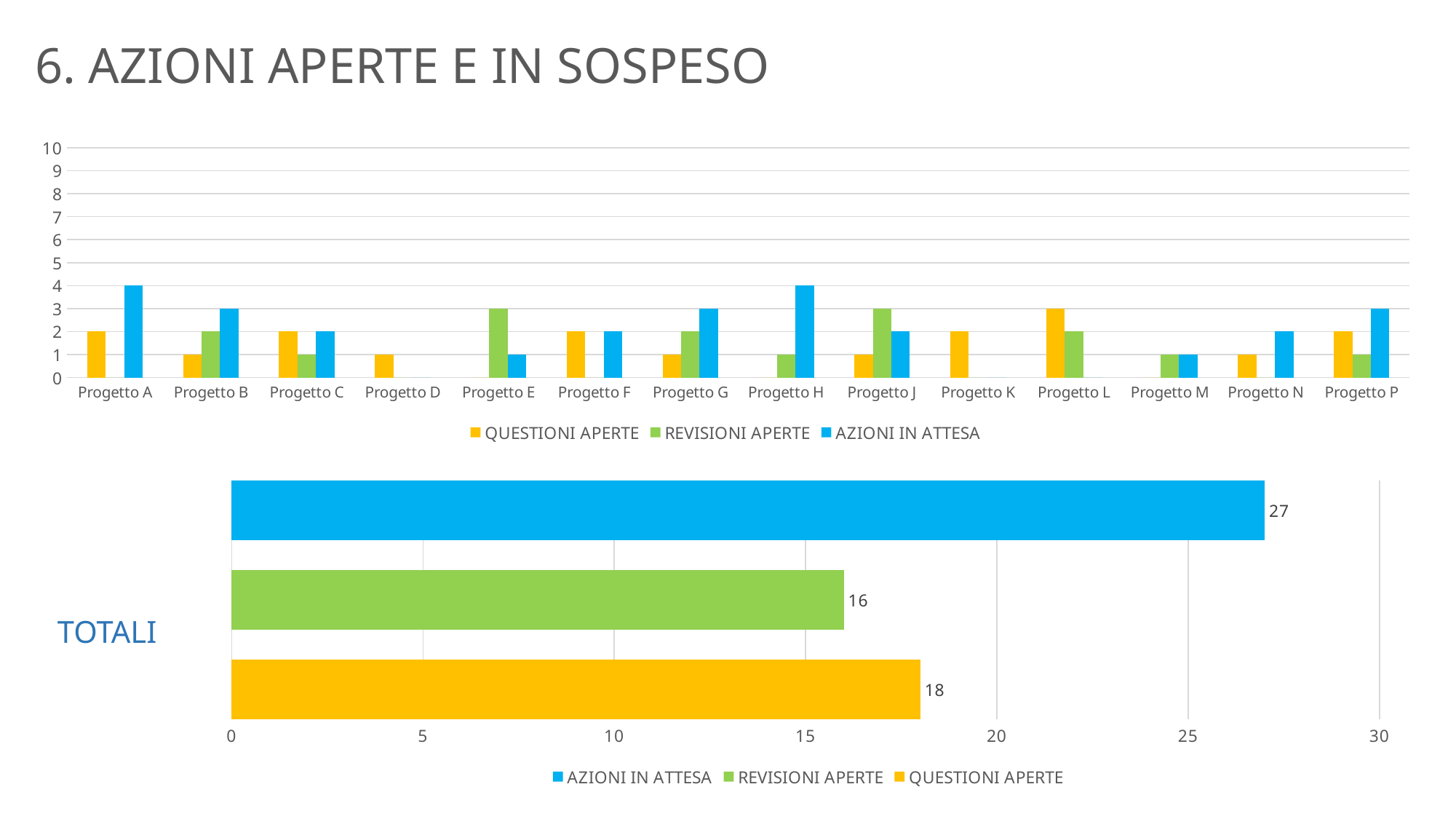
In the top chart, how many projects are shown on the x axis? 14 In the bottom chart (TOTALI), what is the difference between AZIONI IN ATTESA and QUESTIONI APERTE? 9 In the bottom chart (TOTALI), which series has the lowest total? REVISIONI APERTE In the bottom chart (TOTALI), what is the value for AZIONI IN ATTESA? 27 In the bottom chart (TOTALI), which is larger: QUESTIONI APERTE or REVISIONI APERTE? QUESTIONI APERTE In the top chart, which colour represents REVISIONI APERTE? green In the top chart, how many series does the legend list? 3 In the bottom chart (TOTALI), which series has the highest total? AZIONI IN ATTESA In the top chart, what is the value of AZIONI IN ATTESA for Progetto H? 4 In the top chart, what is the value of QUESTIONI APERTE for Progetto L? 3 In the bottom chart (TOTALI), what is the value for REVISIONI APERTE? 16 What kind of chart is the bottom chart (TOTALI)? bar chart